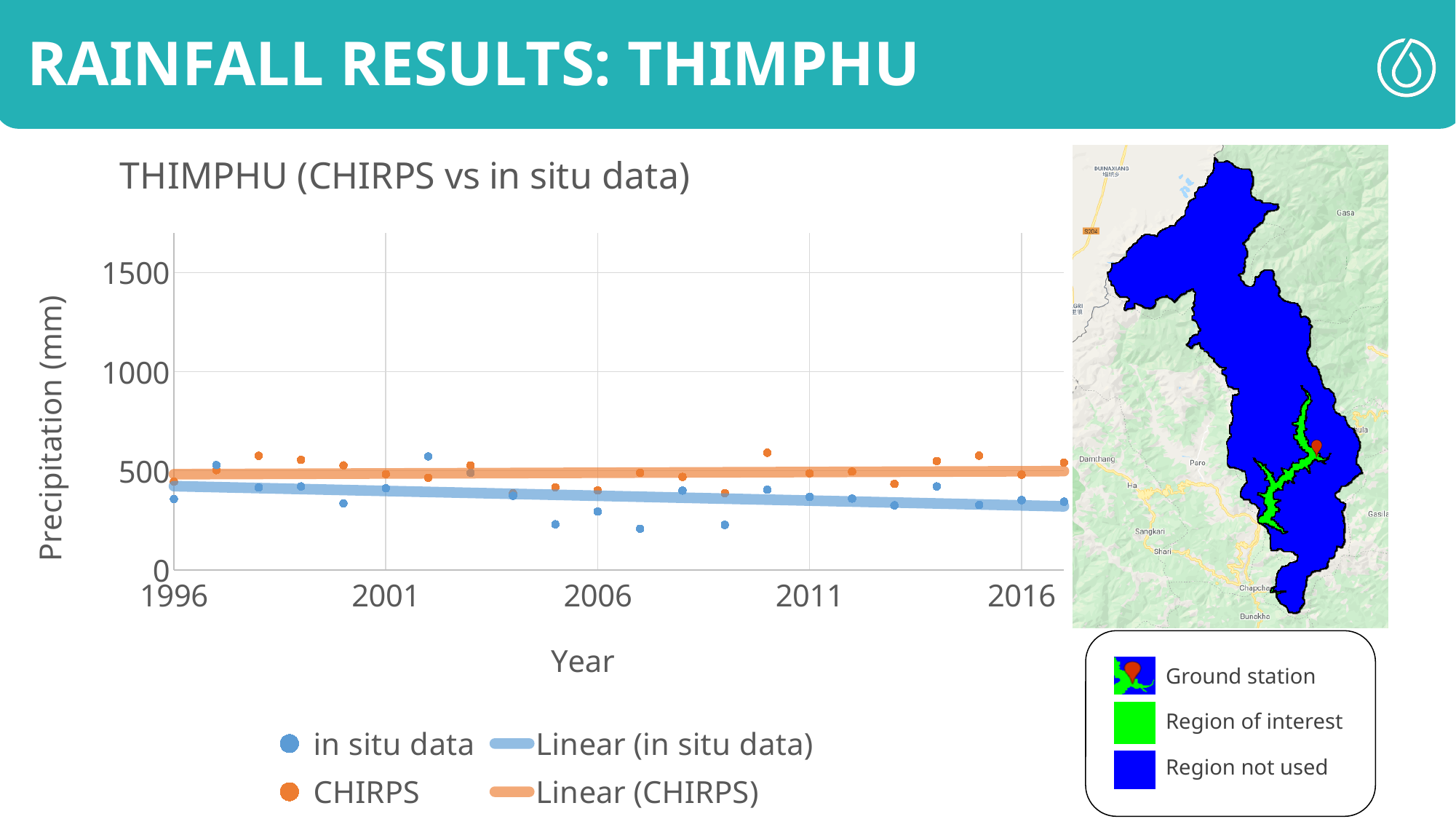
What is the title of the chart? THIMPHU (CHIRPS vs in situ data) What kind of chart is shown on the slide? scatter chart Is the CHIRPS value for 2010 greater or less than 500? greater Is the in situ data value for 2007 greater or less than 500? less Is any plotted value greater or less than 1000? less Does the Linear (in situ data) trend line rise or fall from 1996 to 2016? fall How many entries does the chart legend list? 4 In 2005, which is larger: the CHIRPS value or the in situ data value? CHIRPS Which year has the highest in situ data value? 2002 In 2010, which is larger: the CHIRPS value or the in situ data value? CHIRPS What is the label of the y axis? Precipitation (mm)